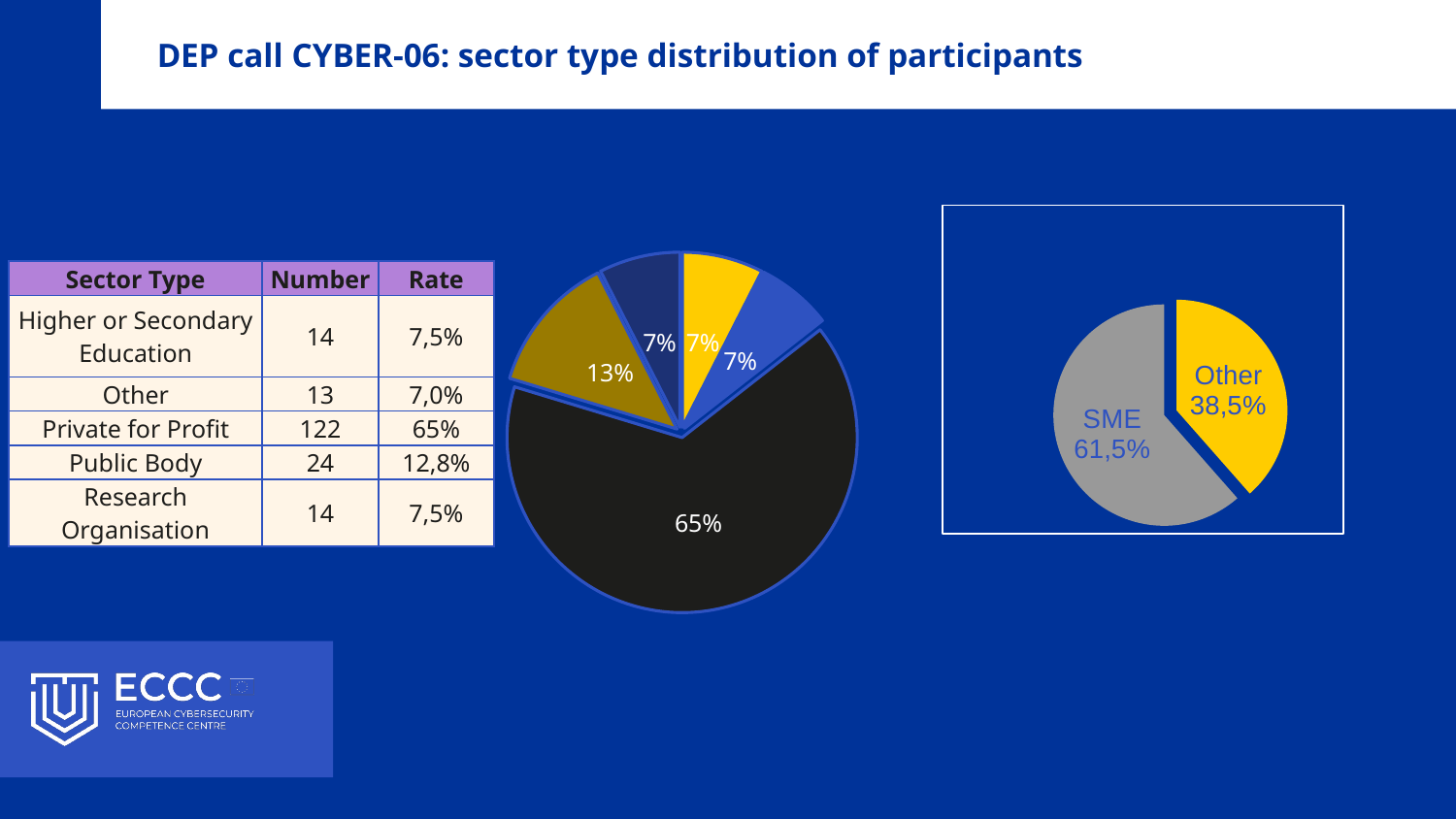
In the large pie chart in the middle of the slide, what is the share of the largest slice? 65% How many slices does the pie chart on the right of the slide have? 2 What kind of chart is the chart on the right of the slide? pie chart In the pie chart on the right of the slide, which slice is larger, SME or Other? SME In the large pie chart in the middle of the slide, how many slices are labelled 7%? 3 What kind of chart is the large chart in the middle of the slide? pie chart In the large pie chart in the middle of the slide, what is the share of the second-largest slice? 13% In the pie chart on the right of the slide, what is the share for SME? 61,5% In the pie chart on the right of the slide, what is the difference between the SME share and the Other share? 23% How many slices does the large pie chart in the middle of the slide have? 5 In the pie chart on the right of the slide, what colour is the SME slice? grey In the pie chart on the right of the slide, what is the share for Other? 38,5%